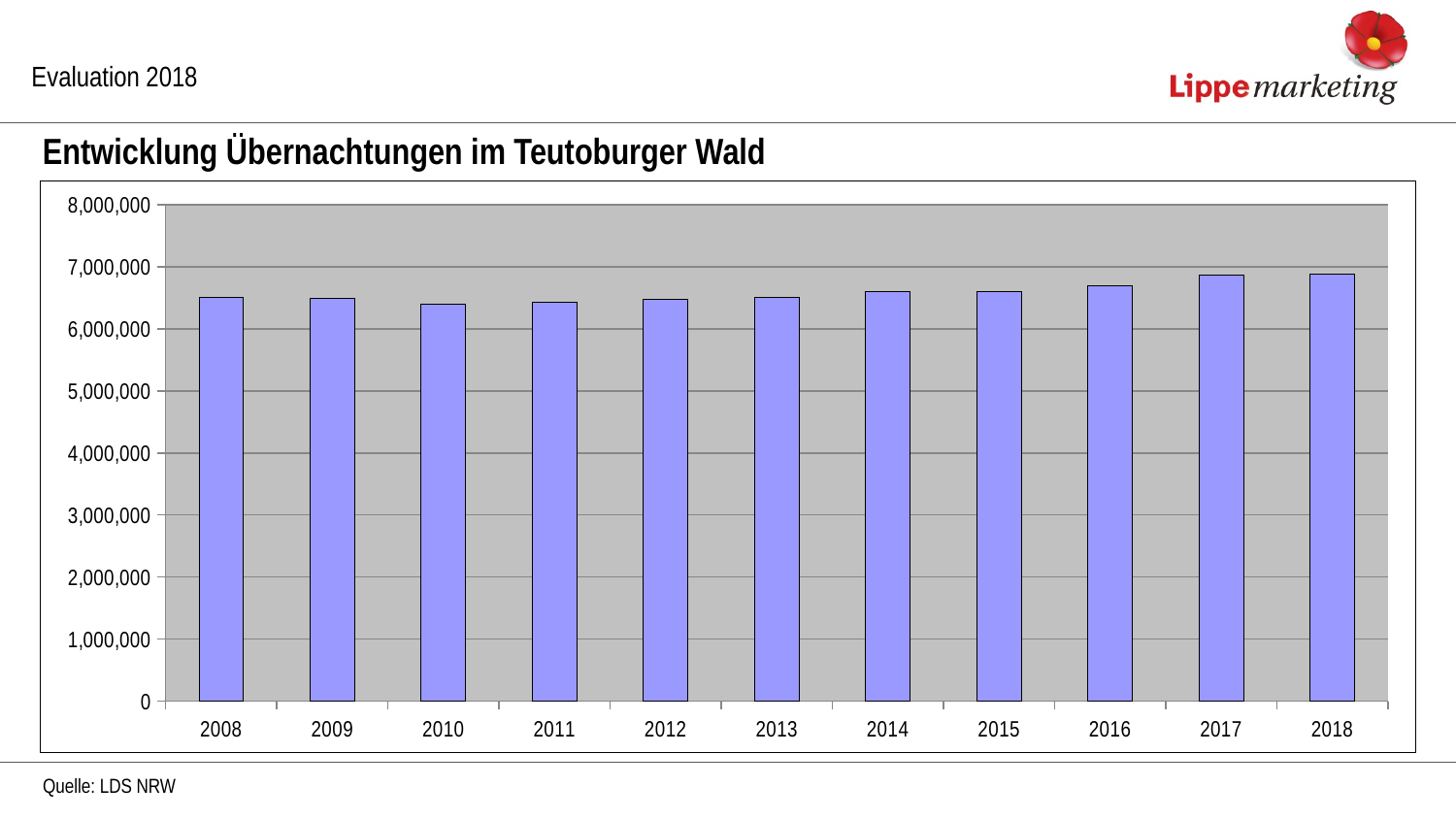
What source is given for the chart data? LDS NRW Is the value for 2018 greater or less than 6,000,000? greater How many years are shown on the x axis of the chart? 11 Which year has the larger value, 2011 or 2018? 2018 Is the value for 2017 greater or less than 7,000,000? less Is the value for 2010 greater or less than 7,000,000? less What is the title of the chart? Entwicklung Übernachtungen im Teutoburger Wald What kind of chart is shown on the slide? bar chart What is the first year shown on the x axis? 2008 Which year has the larger value, 2010 or 2017? 2017 Do the values generally rise or fall from 2010 to 2018? rise